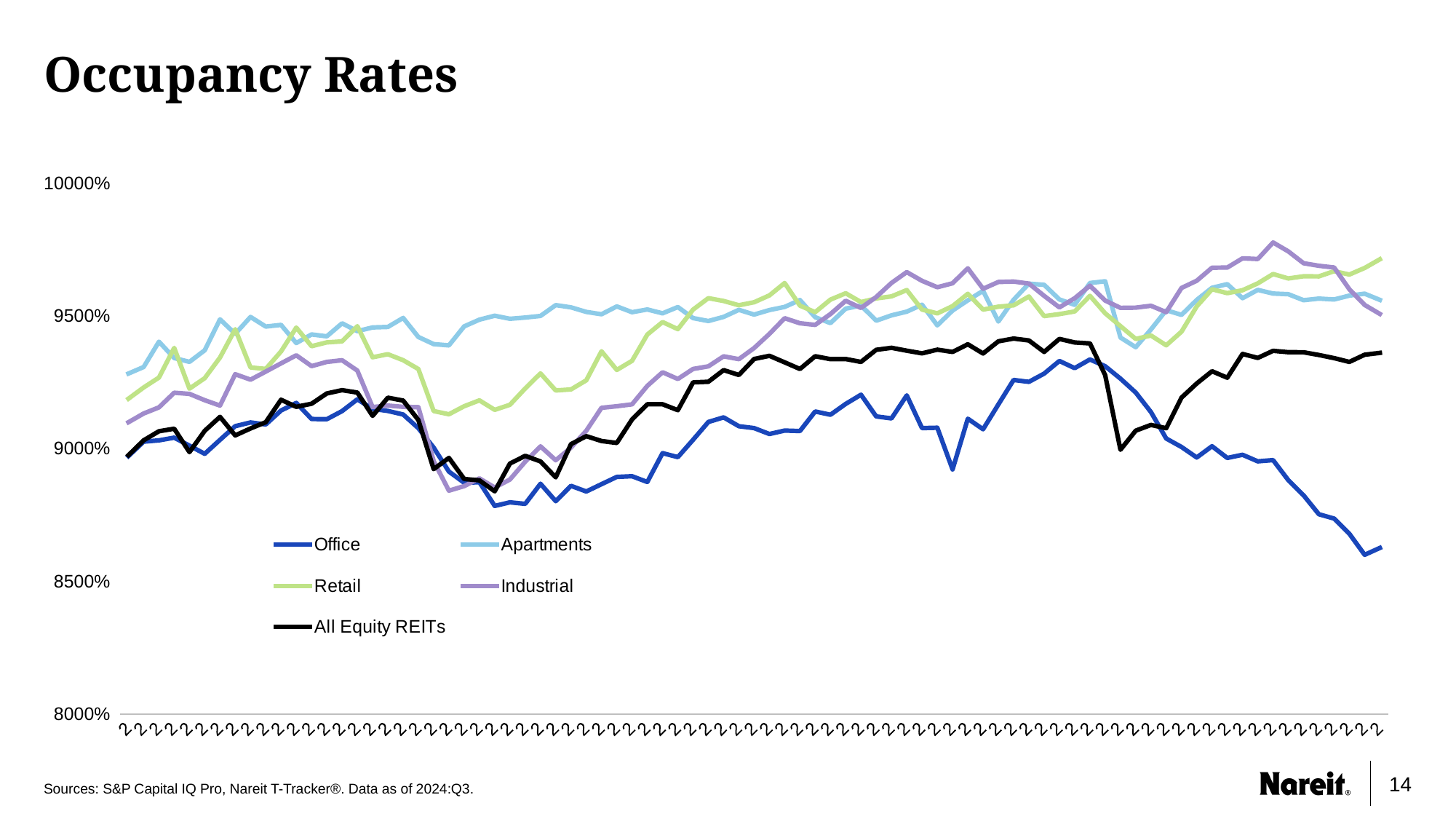
Which series has the highest value at the right end of the chart? Retail What kind of chart is shown on the slide? line chart How many series does the legend list? 5 At the right end of the chart, which is larger, Retail or Office? Retail Is the value for All Equity REITs at the right end of the chart greater or less than 9500%? less Does the Office series rise or fall over the final portion of the chart? fall Is the value for Apartments at the left end of the chart greater or less than 9500%? less Is the value for Office at the right end of the chart greater or less than 9000%? less What is the title of the chart? Occupancy Rates Which series has the lowest value at the right end of the chart? Office Which series is drawn in black? All Equity REITs